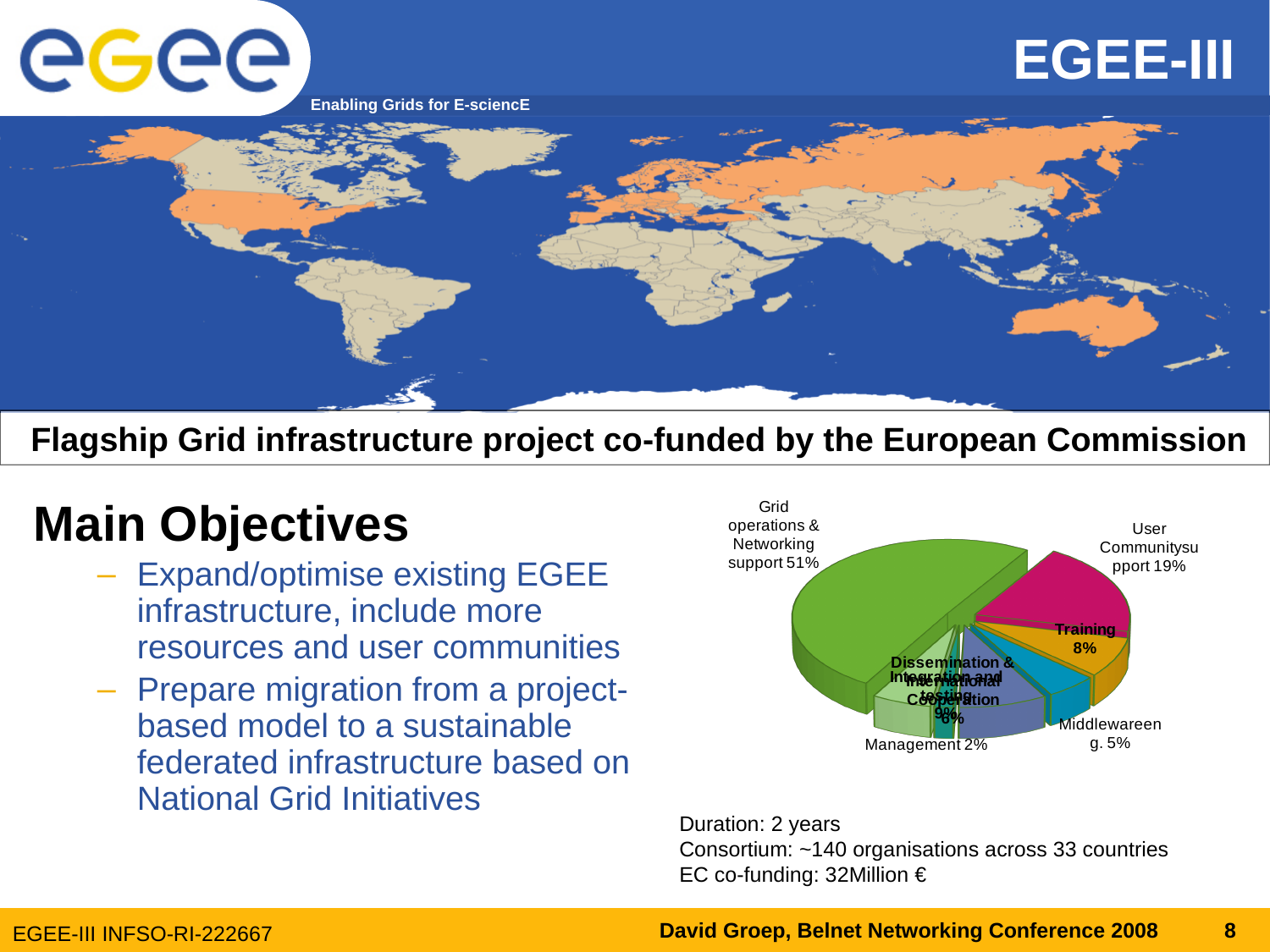
How many percentage points larger is Training than Management? 6 percentage points What share of the pie is Middleware eng.? 5% How many percentage points larger is Grid operations & Networking support than User Community support? 32 percentage points What share of the pie is Management? 2% Which slice of the pie chart is the largest? Grid operations & Networking support What share of the pie is User Community support? 19% What share of the pie is Grid operations & Networking support? 51% What share of the pie is Training? 8% What kind of chart is shown on the slide? pie chart What colour is the Grid operations & Networking support slice in the pie chart? green Which is larger in the pie chart, Training or Middleware eng.? Training Which is larger in the pie chart, User Community support or Grid operations & Networking support? Grid operations & Networking support